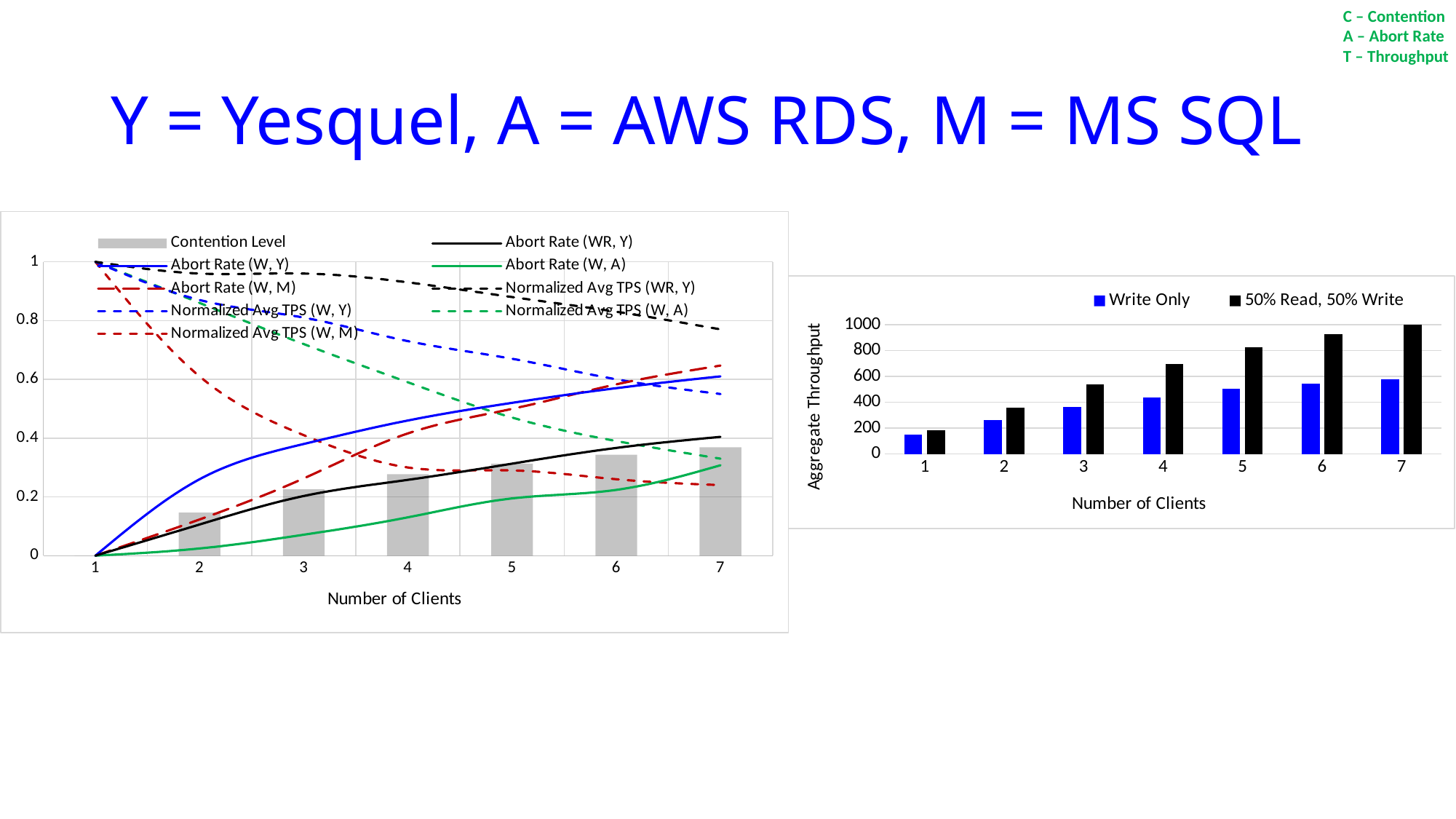
In the right-hand chart, is the Write Only value at 1 client greater or less than 200? less In the left-hand chart, does the Normalized Avg TPS (W, M) line rise or fall as the number of clients increases? fall In the right-hand chart, does the Write Only throughput rise or fall as the number of clients increases? rise In the left-hand chart, is the Contention Level at 7 clients greater or less than 0.2? greater How many series does the legend of the left-hand chart list? 9 How many client counts are shown on the x axis of the right-hand chart? 7 What kind of chart is the chart on the right of the slide? bar chart In the left-hand chart, at 7 clients, which is larger: Abort Rate (W, Y) or Abort Rate (W, A)? Abort Rate (W, Y) In the right-hand chart, is the 50% Read, 50% Write value at 7 clients greater or less than 800? greater In the right-hand chart, which number of clients has the lowest Write Only throughput? 1 How many series does the legend of the right-hand chart list? 2 In the right-hand chart, which number of clients has the highest 50% Read, 50% Write throughput? 7